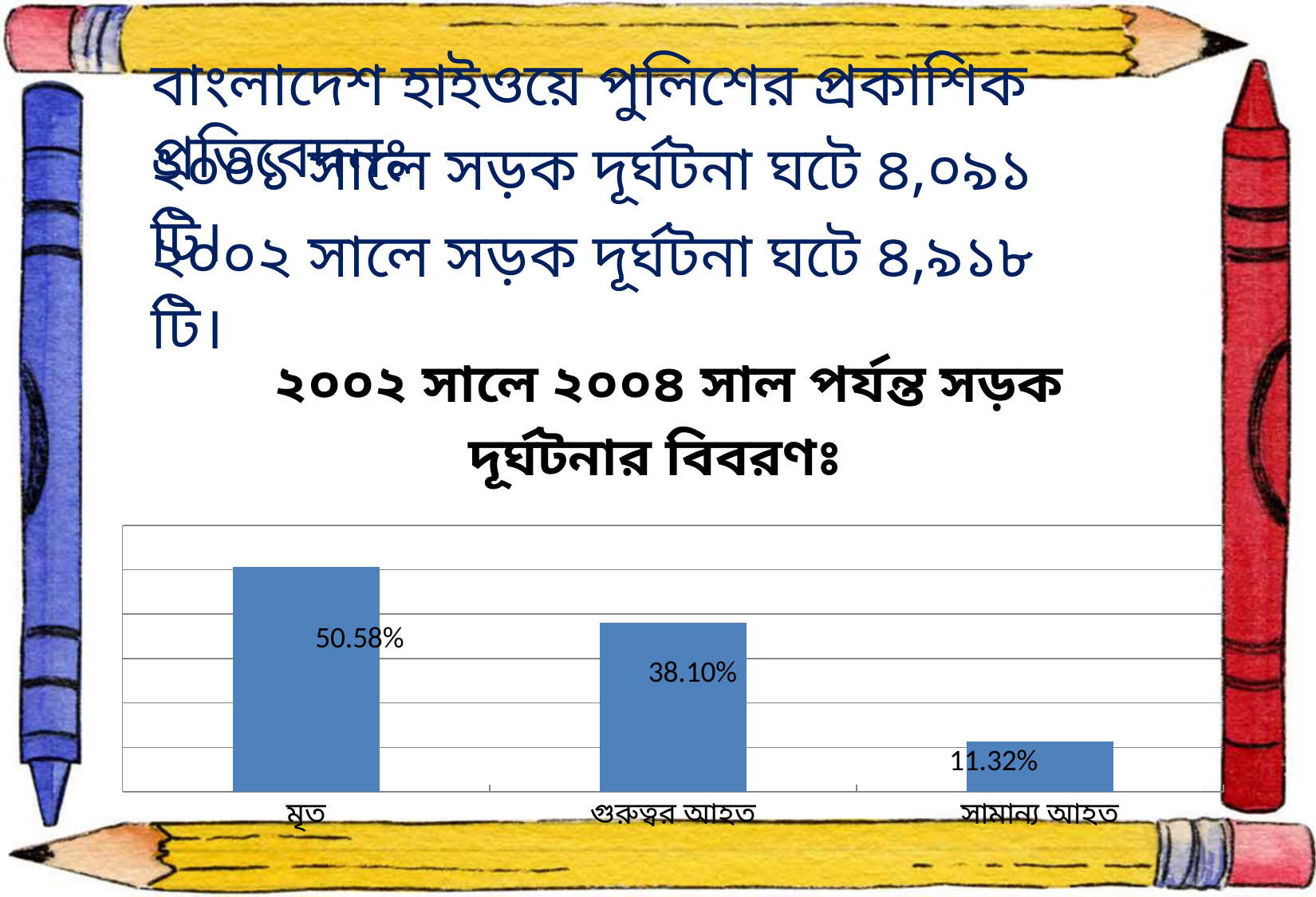
Do the values rise or fall from left to right across the categories? fall How many categories are shown in the chart? 3 What is the value for মৃত? 50.58% What is the title of the chart? ২০০২ সালে ২০০৪ সাল পর্যন্ত সড়ক দূর্ঘটনার বিবরণঃ What is the difference between the values for গুরুতর আহত and সামান্য আহত? 26.78% Which category has the lowest value? সামান্য আহত Which is larger, the value for গুরুতর আহত or the value for সামান্য আহত? গুরুত্বর আহত What is the value for সামান্য আহত? 11.32% What kind of chart is shown on the slide? bar chart What is the value for গুরুতর আহত? 38.10% Which category has the highest value? মৃত What is the difference between the values for মৃত and গুরুতর আহত? 12.48%